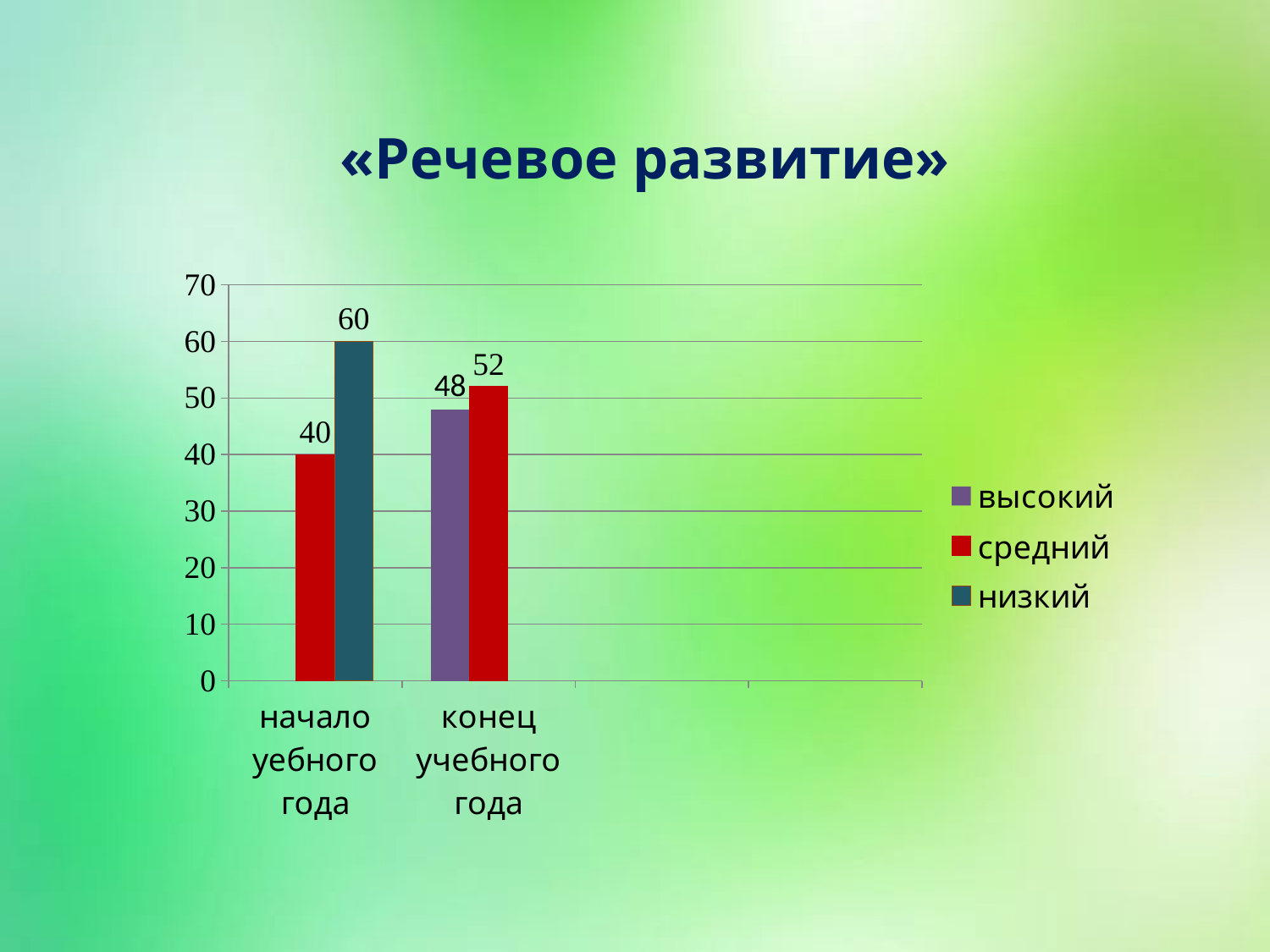
Which series has the lowest value at конец учебного года? высокий Which is larger: средний at начало уебного года or средний at конец учебного года? средний at конец учебного года What is the difference between the низкий and средний values at начало уебного года? 20 What is the value for высокий at конец учебного года? 48 What is the value for низкий at начало уебного года? 60 What is the title of the slide? «Речевое развитие» How many series does the legend list? 3 How much did the средний value change from начало уебного года to конец учебного года? 12 Which series has the highest value at начало уебного года? низкий What is the value for средний at конец учебного года? 52 What kind of chart is shown on the slide? bar chart What is the value for средний at начало уебного года? 40